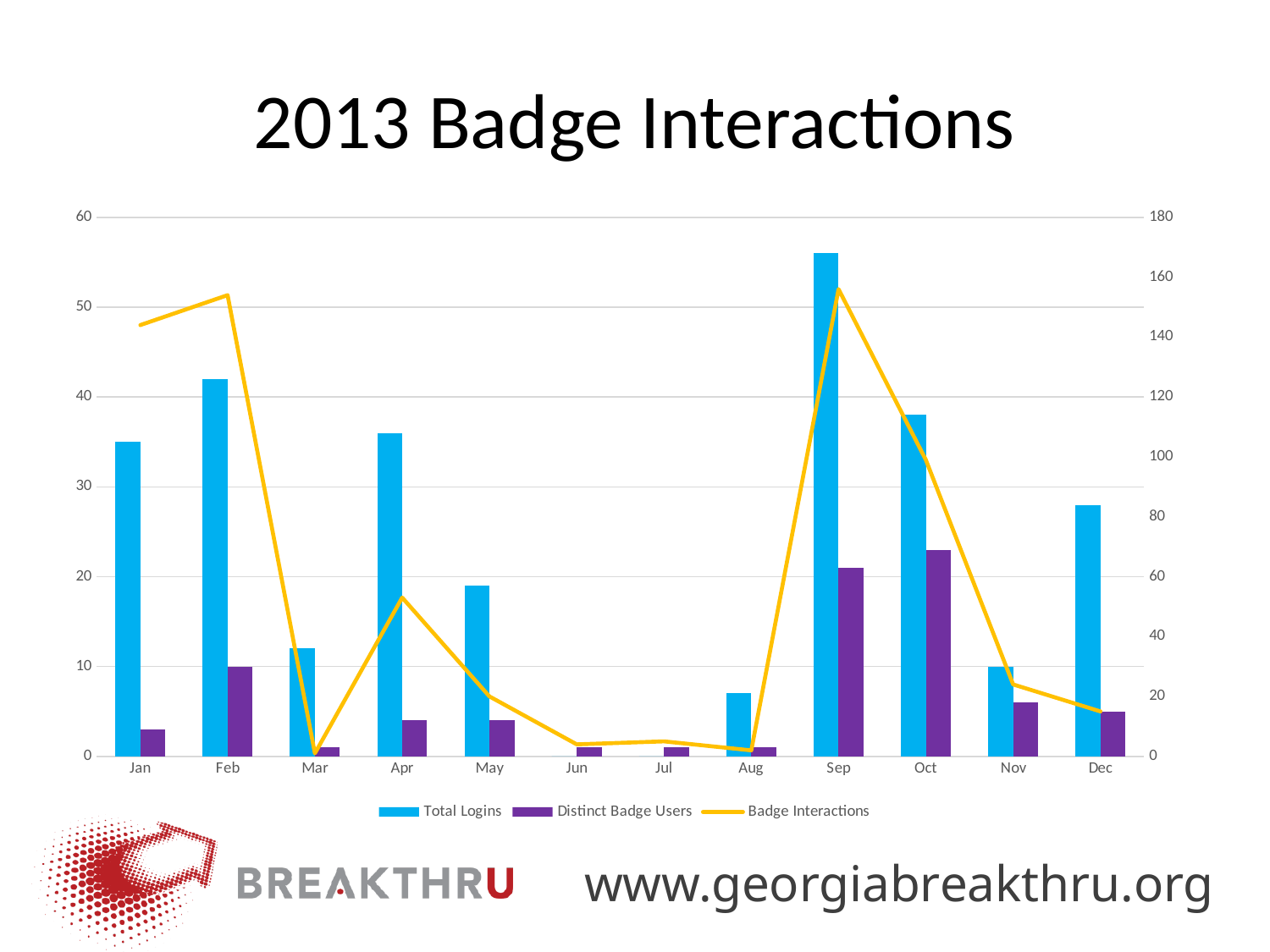
Is the Badge Interactions value for Apr greater or less than 40? greater How many series does the legend list? 3 Is the Total Logins value for Jan greater or less than 40? less Is the Total Logins value for Sep greater or less than 50? greater What kind of chart is this? Combined bar and line chart How many months are shown on the x axis? 12 Which is larger, Distinct Badge Users in Feb or Distinct Badge Users in Nov? Feb What is the title of the chart? 2013 Badge Interactions Which month has the highest Total Logins? Sep Do Badge Interactions rise or fall from Sep to Dec? fall Which is larger, Total Logins in Feb or Total Logins in Apr? Feb